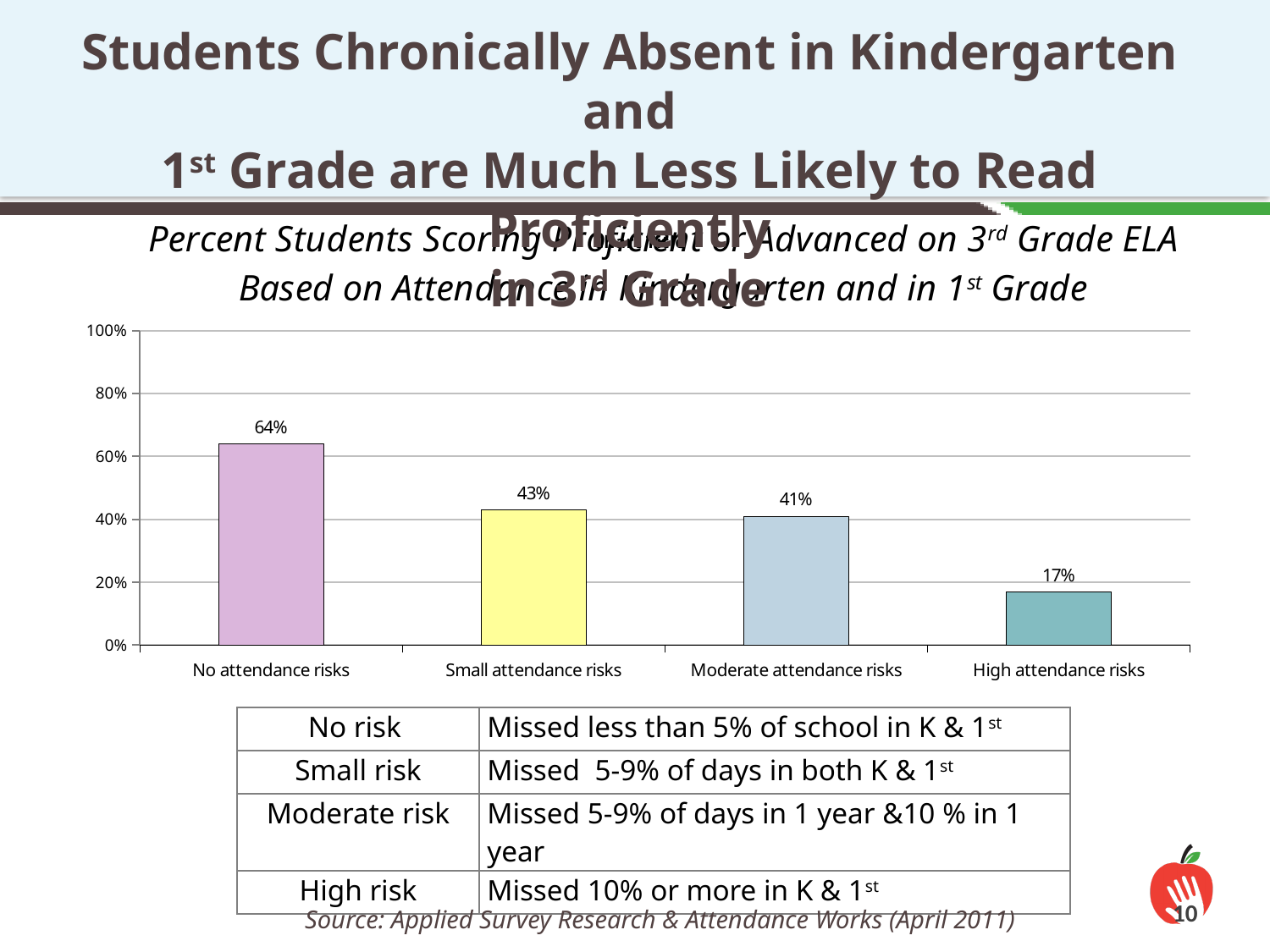
How many attendance risk categories are plotted on the chart? 4 What kind of chart is shown on the slide? Bar chart What is the value shown for the High attendance risks category? 17% What is the value shown for the Small attendance risks category? 43% What is the difference in percentage points between the No attendance risks and High attendance risks categories? 47 What percent of students with no attendance risks scored proficient or advanced on 3rd grade ELA? 64% Do the values rise or fall as you move from No attendance risks to High attendance risks along the x axis? Fall Is the value for No attendance risks greater or less than 60%? greater Which attendance risk category has the highest percent of students scoring proficient or advanced? No attendance risks Which is larger, the value for Small attendance risks or the value for High attendance risks? Small attendance risks What is the value shown for the Moderate attendance risks category? 41% Which attendance risk category has the lowest percent of students scoring proficient or advanced? High attendance risks